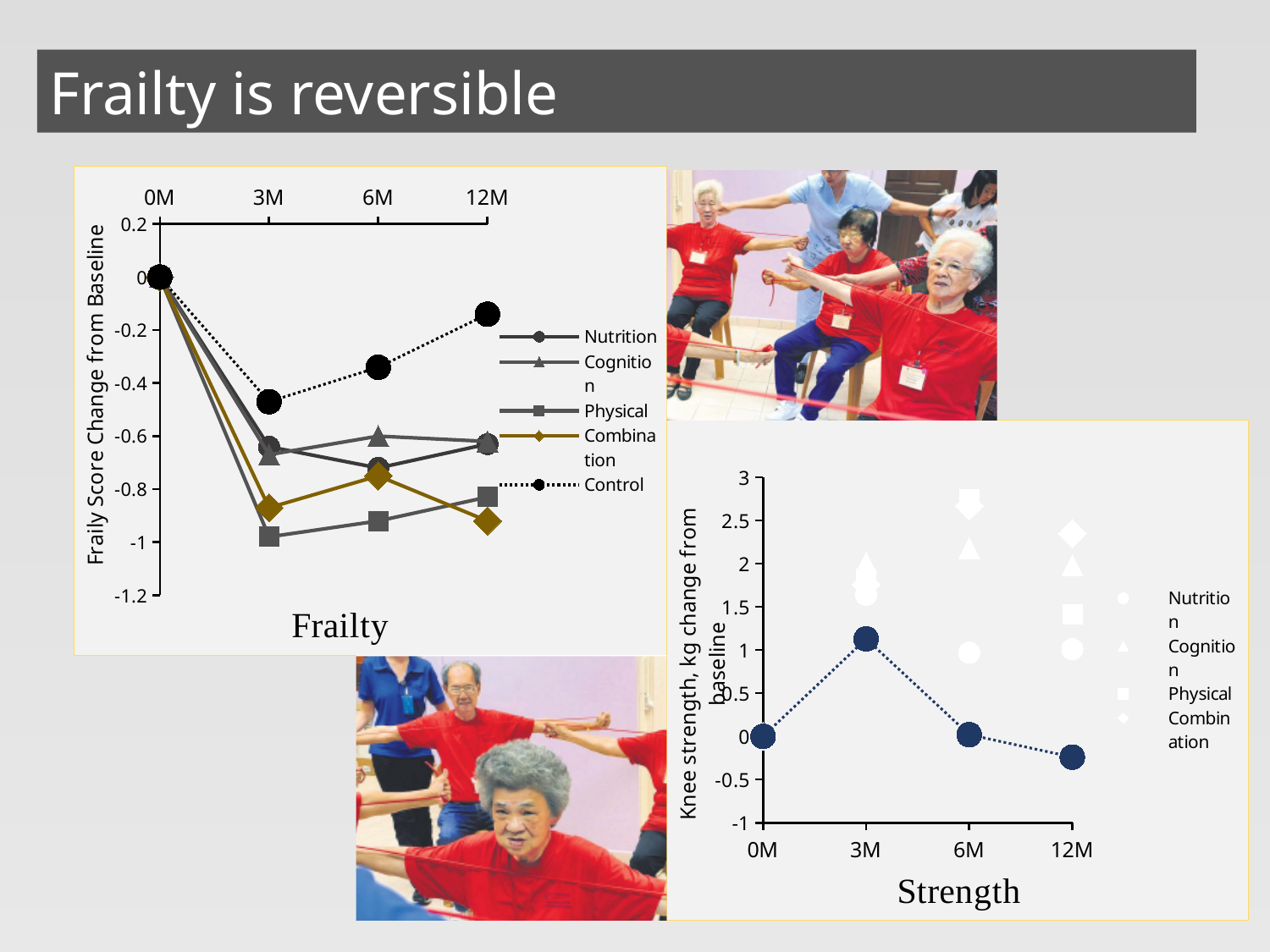
On the Strength chart, is the value for Nutrition at 6M greater or less than 1.5? less On the Frailty chart, how many time points are shown on the x axis? 4 On the Frailty chart, which series has the lowest value at 3M? Physical On the Frailty chart, how many series does the legend list? 5 On the Frailty chart, is the value for Physical at 3M greater or less than -0.8? less On the Frailty chart, what kind of chart is shown? line chart On the Frailty chart, is the value for Control at 3M greater or less than -0.4? less On the Frailty chart, which series has the highest value at 12M? Control On the Frailty chart, does the Control series rise or fall from 3M to 12M? rises On the Strength chart, which is larger at 12M, Combination or Nutrition? Combination On the Strength chart, how many series does the legend list? 4